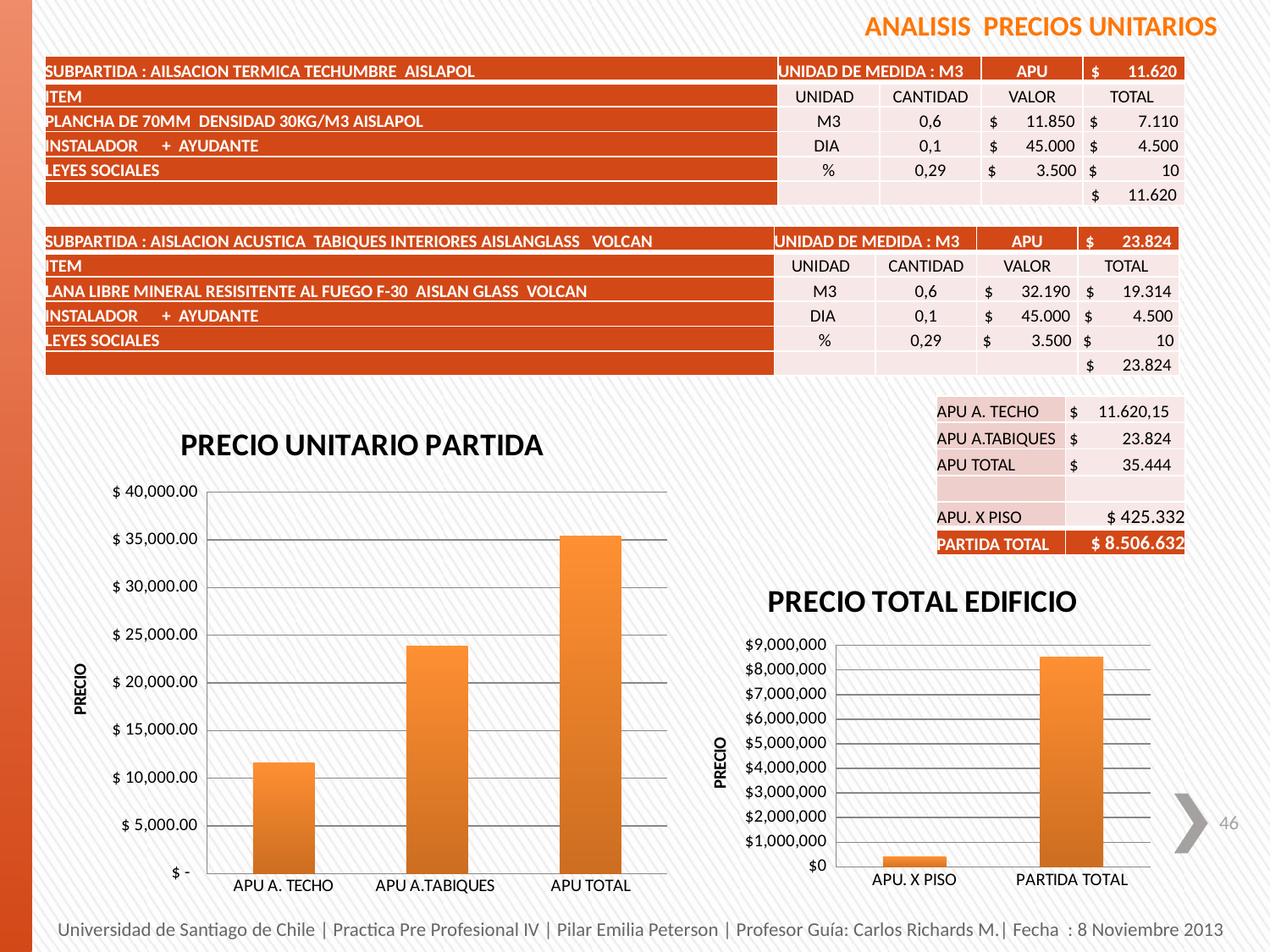
In the PRECIO UNITARIO PARTIDA chart, do the values rise or fall from left to right along the x axis? rise What kind of chart is PRECIO UNITARIO PARTIDA? bar chart In the PRECIO UNITARIO PARTIDA chart, is the value for APU A. TECHO greater or less than $ 10,000.00? greater In the PRECIO UNITARIO PARTIDA chart, how many categories are plotted? 3 In the PRECIO TOTAL EDIFICIO chart, which category has the higher value, APU. X PISO or PARTIDA TOTAL? PARTIDA TOTAL In the PRECIO UNITARIO PARTIDA chart, which category has the lowest value? APU A. TECHO In the PRECIO TOTAL EDIFICIO chart, what is the label on the vertical axis? PRECIO In the PRECIO UNITARIO PARTIDA chart, is the value for APU A.TABIQUES greater or less than $ 25,000.00? less In the PRECIO UNITARIO PARTIDA chart, which category has the highest value? APU TOTAL In the PRECIO UNITARIO PARTIDA chart, is the value for APU TOTAL greater or less than $ 30,000.00? greater